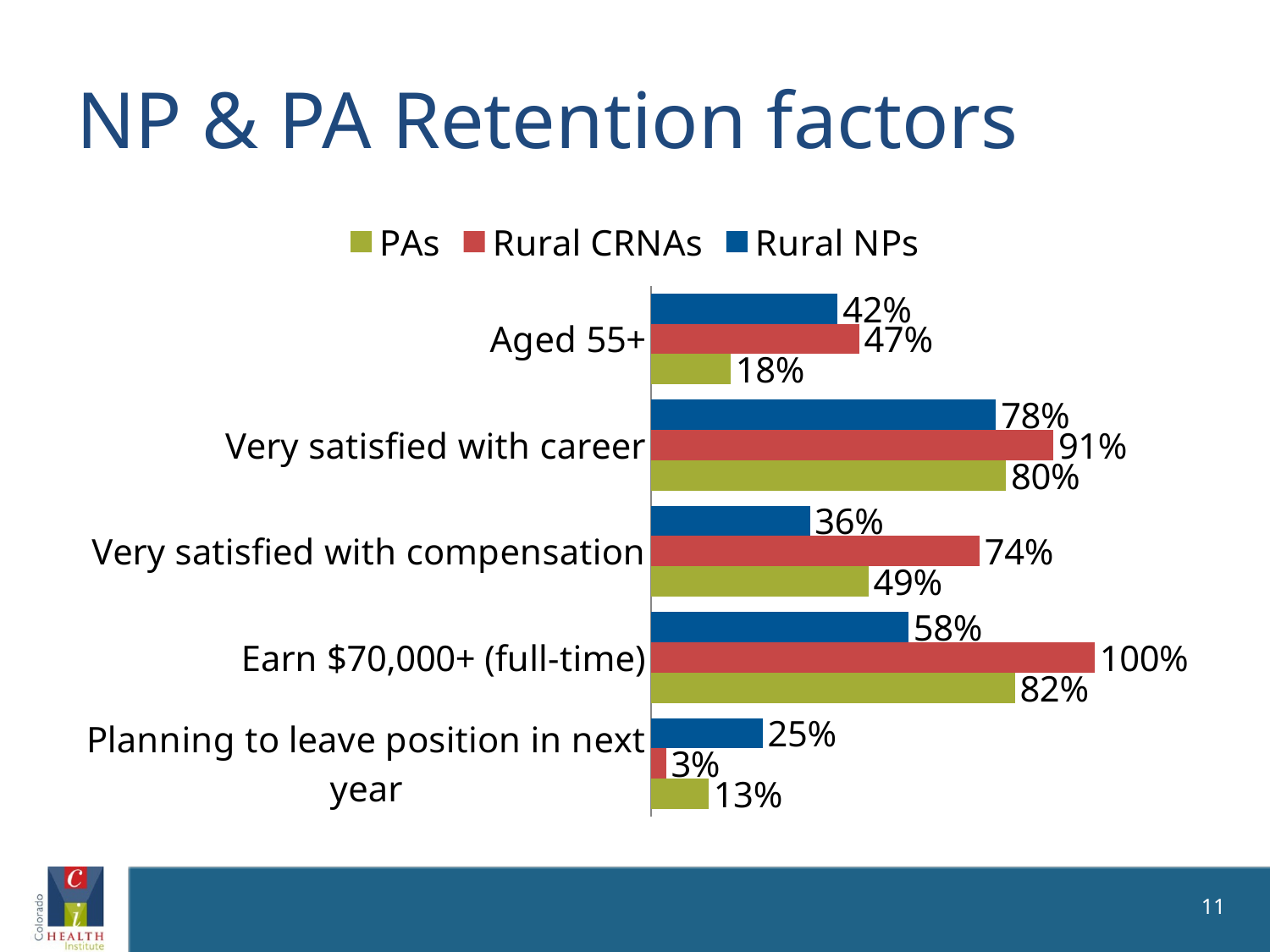
Which colour represents Rural NPs in the chart? Blue What percentage of Rural CRNAs earn $70,000+ (full-time)? 100% Which group has the lowest percentage planning to leave position in next year? Rural CRNAs What is the difference between the Rural CRNAs and Rural NPs values for Earn $70,000+ (full-time)? 42% What kind of chart is shown on the slide? Bar chart What percentage of Rural NPs are planning to leave their position in the next year? 25% What percentage of PAs are aged 55+? 18% Which is larger: the PAs value or the Rural NPs value for Very satisfied with compensation? PAs What percentage of Rural CRNAs are very satisfied with compensation? 74% How many series does the legend list? 3 Which group has the highest percentage very satisfied with career? Rural CRNAs How many retention factor categories are shown on the chart? 5